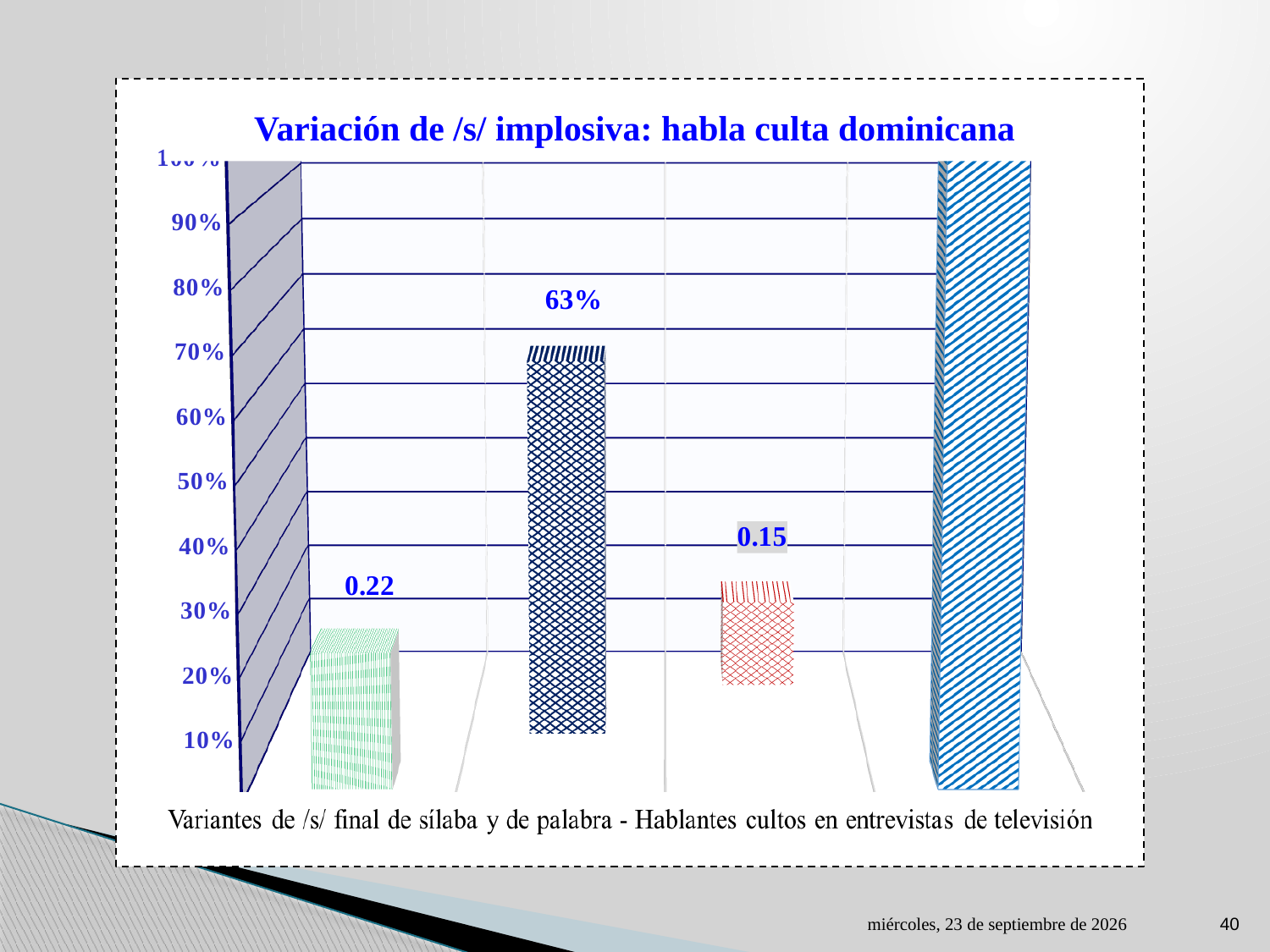
Which bar has the highest value? the rightmost bar What value is labelled on the leftmost bar? 0.22 What caption appears below the chart? Variantes de /s/ final de sílaba y de palabra - Hablantes cultos en entrevistas de televisión What kind of chart is shown on the slide? bar chart How many bars are plotted in the chart? 4 What is the title of the chart? Variación de /s/ implosiva: habla culta dominicana